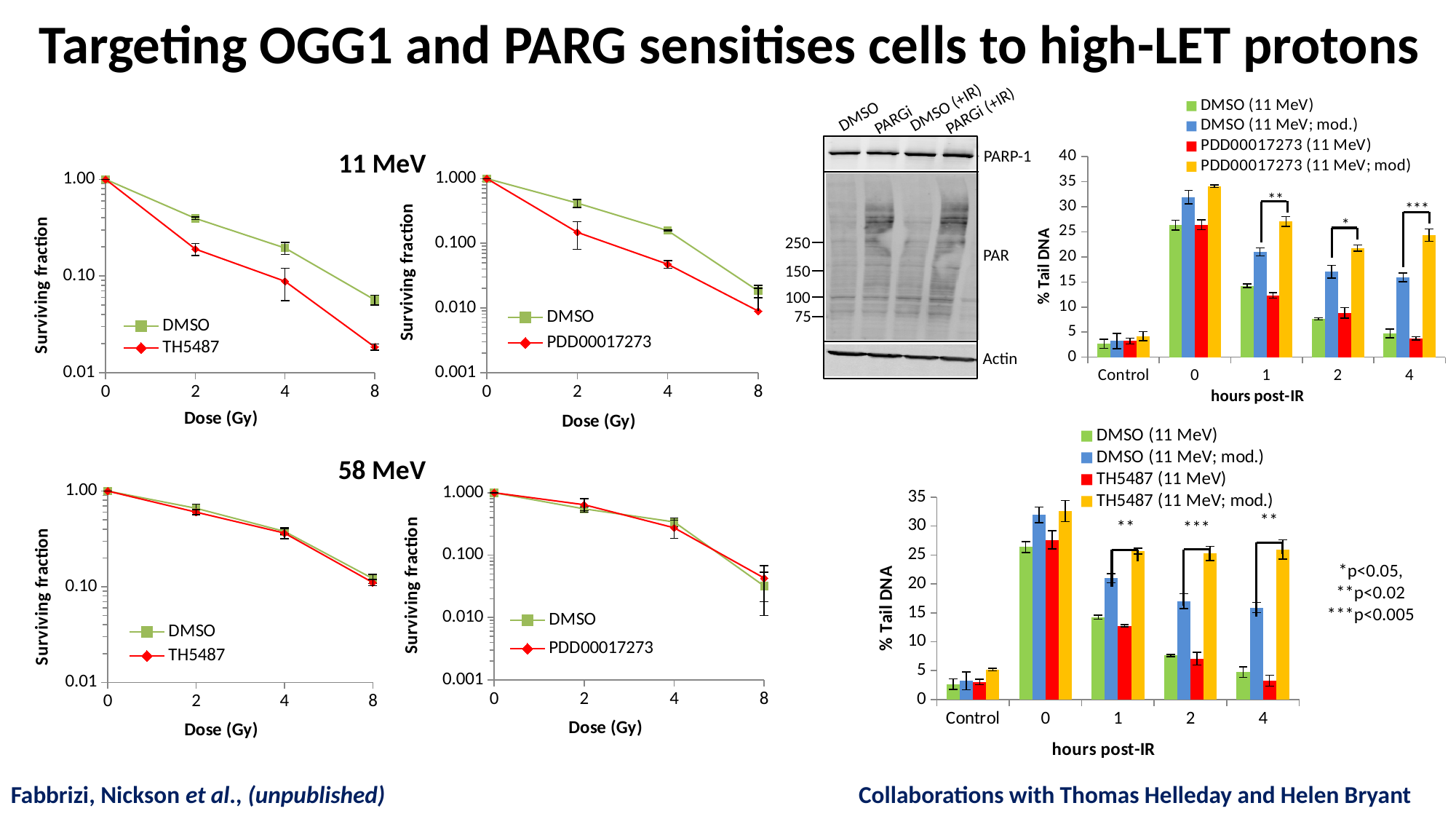
What is the x-axis label of the bottom-right bar chart (% Tail DNA, TH5487 legend)? hours post-IR In the bottom-right bar chart (% Tail DNA, TH5487 legend), is the value for TH5487 (11 MeV) at 4 hours post-IR greater or less than 5? less In the bottom-right bar chart (% Tail DNA, TH5487 legend), how many categories are shown on the x axis? 5 In the top-right bar chart (% Tail DNA, PDD00017273 legend), how many series does the legend list? 4 In the top-left line chart (11 MeV, DMSO vs TH5487), how many series does the legend list? 2 In the top-left line chart (11 MeV, DMSO vs TH5487), does the DMSO surviving fraction rise or fall as dose increases? fall In the top-right bar chart (% Tail DNA, PDD00017273 legend), is the value for DMSO (11 MeV; mod.) at 0 hours post-IR greater or less than 30? greater What kind of chart is the top-left chart showing Surviving fraction against Dose (Gy) for DMSO and TH5487? line chart In the top-left line chart (11 MeV, DMSO vs TH5487), at 8 Gy which series has the higher surviving fraction? DMSO In the top-right bar chart (% Tail DNA, PDD00017273 legend), at 1 hour post-IR, which is larger: PDD00017273 (11 MeV; mod) or PDD00017273 (11 MeV)? PDD00017273 (11 MeV; mod) What kind of chart is the top-right chart with the y axis '% Tail DNA' and legend including PDD00017273? bar chart In the top-right bar chart (% Tail DNA, PDD00017273 legend), is the value for DMSO (11 MeV) at 4 hours post-IR greater or less than 10? less